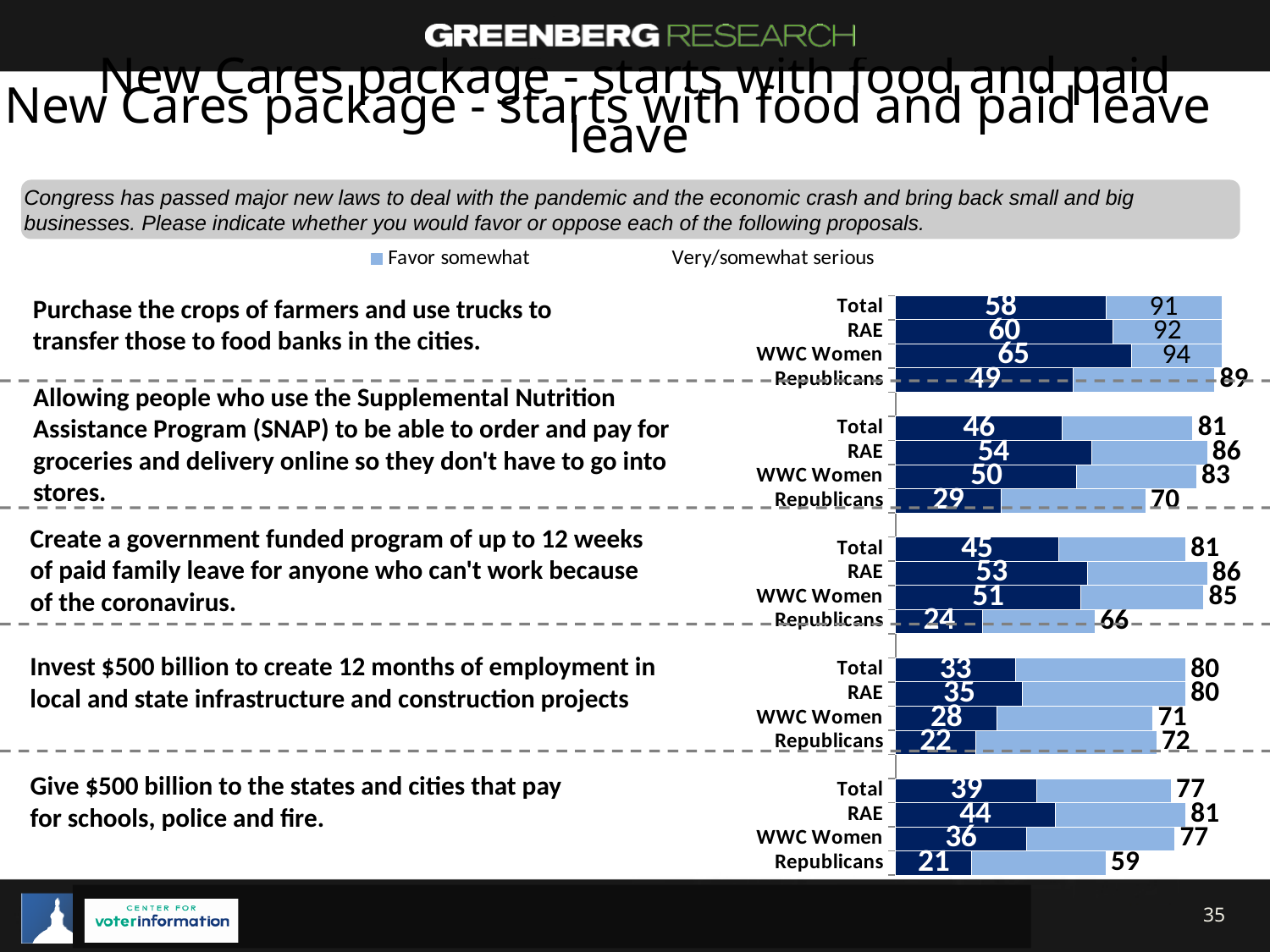
In the chart for 'Give $500 billion to the states and cities that pay for schools, police and fire', what is the total value shown for Republicans? 59 In the chart for 'Give $500 billion to the states and cities that pay for schools, police and fire', what is the difference between the dark blue values for RAE and Total? 5 In the chart for the 12 weeks of paid family leave proposal, what is the difference between the total values for RAE and Republicans? 20 In the chart for the SNAP online ordering proposal, which group has the lowest dark blue value? Republicans In the chart for the SNAP online ordering proposal, what is the total value shown for RAE? 86 In the chart for 'Invest $500 billion to create 12 months of employment in local and state infrastructure and construction projects', which group has the highest dark blue value? RAE In the chart for 'Purchase the crops of farmers and use trucks to transfer those to food banks in the cities', what is the dark blue value for WWC Women? 65 What type of chart is used for each proposal on the slide? Stacked bar chart In the chart for 'Purchase the crops of farmers and use trucks to transfer those to food banks in the cities', what is the total value shown at the end of the Republicans bar? 89 How many groups are shown in each of the bar charts on the slide? 4 In the chart for 'Invest $500 billion to create 12 months of employment in local and state infrastructure and construction projects', is the total value for WWC Women larger or smaller than the total value for Republicans? smaller In the chart for the 12 weeks of paid family leave proposal, what is the dark blue value for Republicans? 24